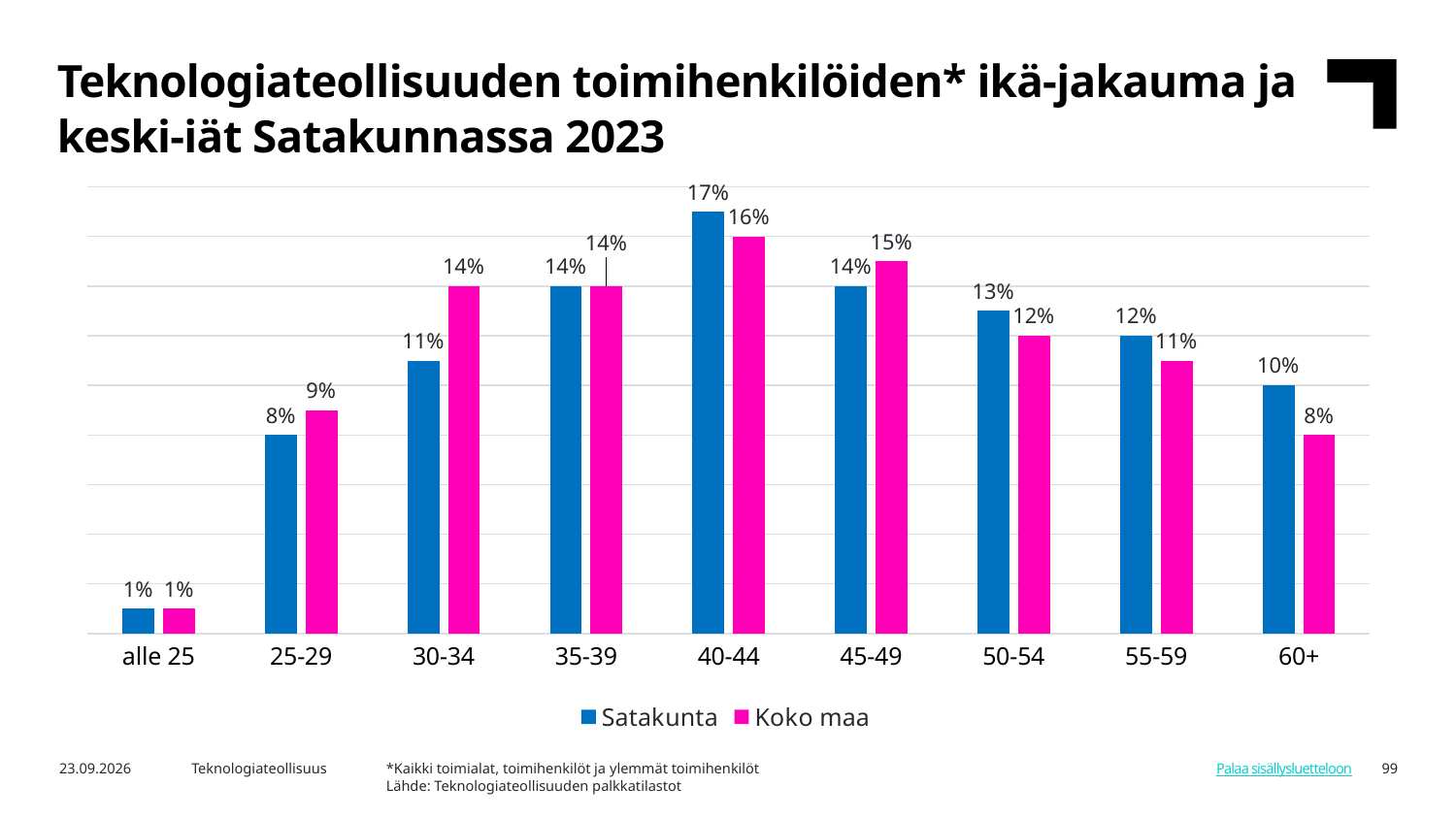
What is the difference between the Satakunta and Koko maa values for the 30-34 age group? 3% Which age group has the lowest Koko maa value? alle 25 What is the Satakunta value for the 40-44 age group? 17% What is the difference between the Satakunta values for 40-44 and 60+? 7% What is the Koko maa value for the 30-34 age group? 14% What kind of chart is shown on the slide? Bar chart For the 45-49 age group, which series has the larger value, Satakunta or Koko maa? Koko maa What is the Satakunta value for the 60+ age group? 10% How many series does the legend list? 2 How many age groups are shown on the x axis? 9 For the 55-59 age group, which series has the larger value, Satakunta or Koko maa? Satakunta Which age group has the highest Satakunta value? 40-44